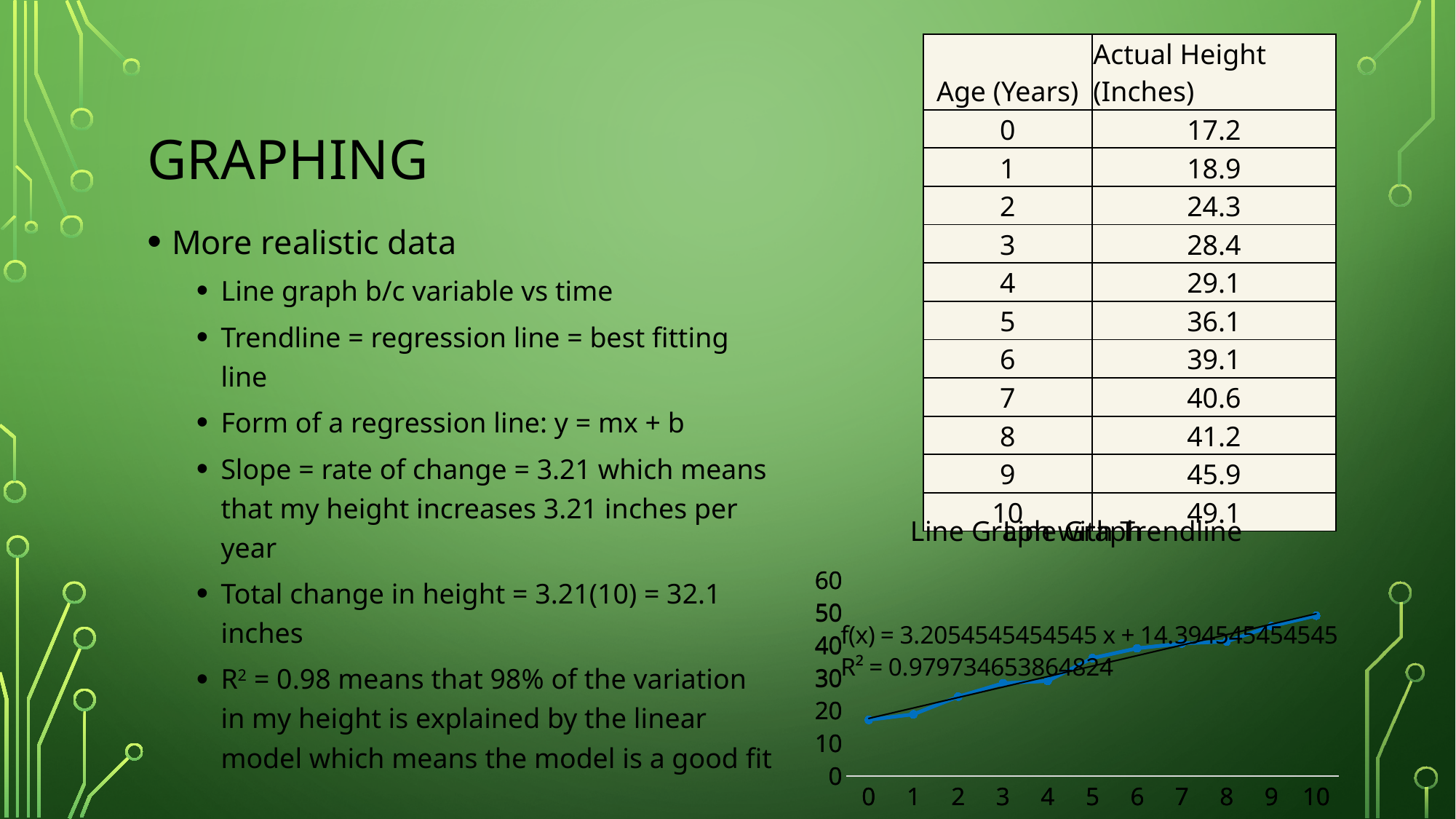
How many data points are plotted on the line chart? 11 According to the table, what is the actual height in inches at age 5? 36.1 Using the table values, what is the difference between the height at age 10 and the height at age 0? 31.9 Do the plotted height values rise or fall as age increases along the x axis? rise What R² value is displayed on the chart? 0.979734653864824 Is the plotted value at age 0 greater or less than 20? less Which is larger, the height at age 8 or the height at age 2? age 8 At which age is the plotted height highest? 10 What kind of chart is shown at the bottom right of the slide? line chart At which age is the plotted height lowest? 0 Is the plotted value at age 5 greater or less than 30? greater Is the plotted value at age 10 greater or less than 40? greater